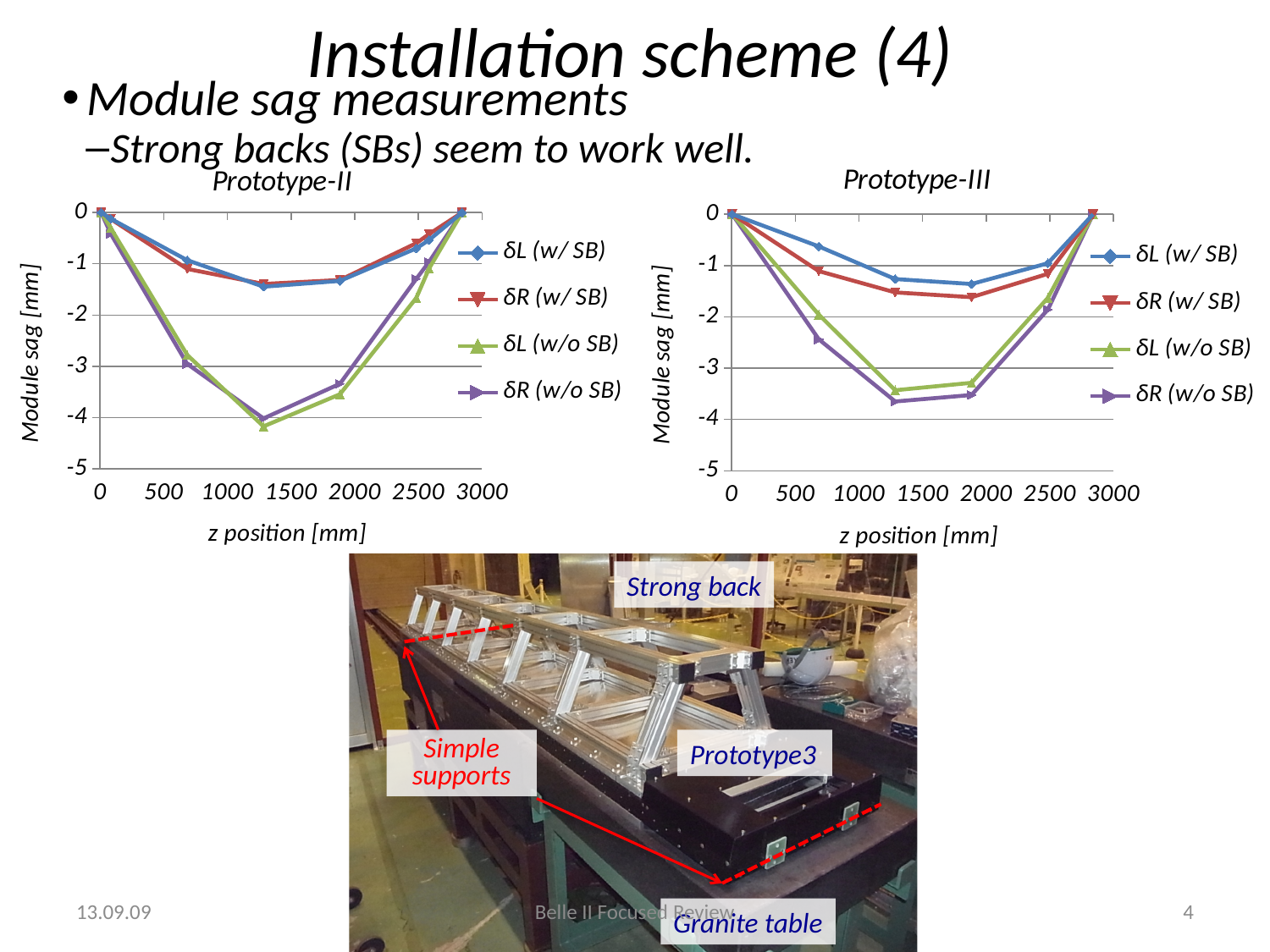
In the Prototype-II chart, what is the value of δL (w/ SB) at z position 0? 0 What is the x-axis title of the Prototype-III chart? z position [mm] In the Prototype-III chart, is the lowest value of δR (w/ SB) greater or less than -1? less How many series does the legend of the Prototype-III chart list? 4 In the Prototype-II chart, is the lowest value of δL (w/o SB) greater or less than -4? less In the Prototype-III chart, do the values of δL (w/o SB) rise or fall from z position 0 to about 1250? fall In the Prototype-III chart, is the lowest value of δL (w/o SB) greater or less than -4? greater In the Prototype-III chart, which series reaches a lower module sag, δR (w/ SB) or δR (w/o SB)? δR (w/o SB) What kind of chart is the Prototype-II chart? line chart In the Prototype-II chart, which series reaches a lower module sag, δL (w/ SB) or δL (w/o SB)? δL (w/o SB) What is the y-axis title of the Prototype-II chart? Module sag [mm]